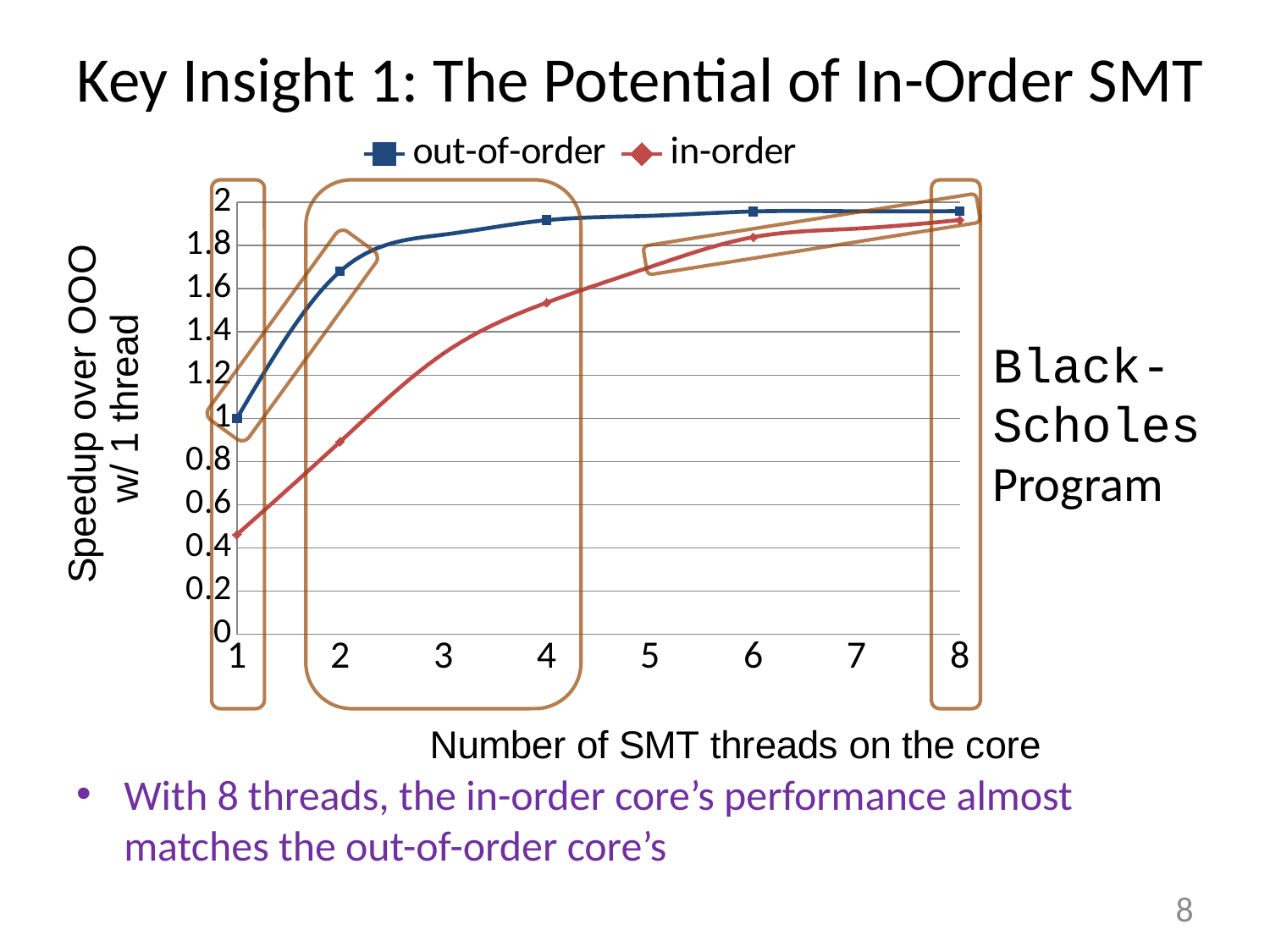
Does the in-order series rise or fall as the number of SMT threads increases? rise Is the value for the in-order series at 4 threads greater or less than 1.4? greater What are the two series named in the legend? out-of-order and in-order Is the value for the in-order series at 2 threads greater or less than 1? less How many series does the legend list? 2 What kind of chart is shown on the slide? line chart What is the speedup of the out-of-order series at 1 thread? 1 Is the value for the out-of-order series at 4 threads greater or less than 1.8? greater At 4 threads, which series has the higher speedup, out-of-order or in-order? out-of-order What is the title of the x axis? Number of SMT threads on the core